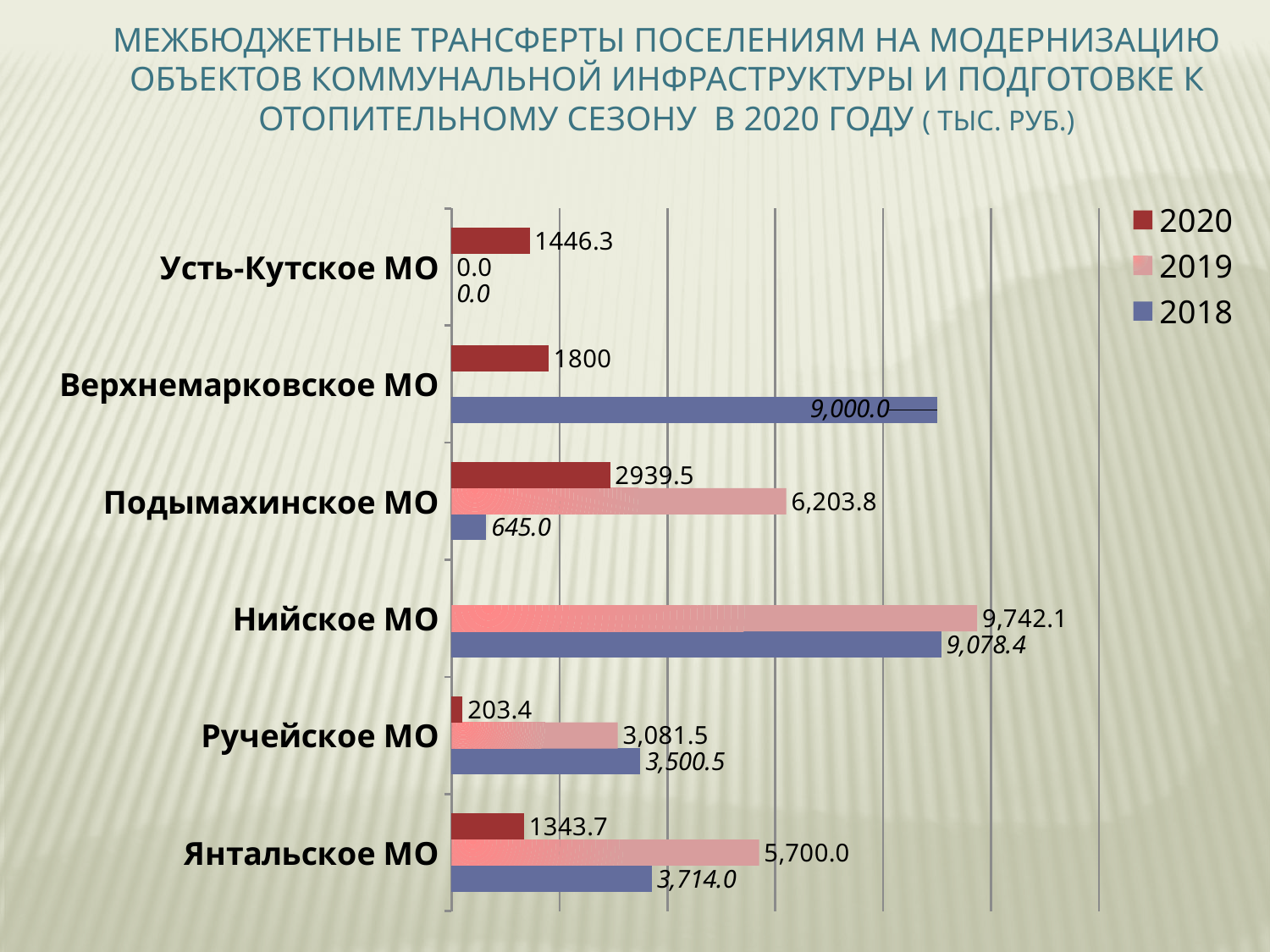
What is the difference between the 2019 and 2018 values for Янтальское МО? 1,986.0 Which municipality has the highest 2020 value? Подымахинское МО What is the 2018 value for Верхнемарковское МО? 9,000.0 What is the 2019 value for Янтальское МО? 5,700.0 What is the 2020 value for Подымахинское МО? 2939.5 What kind of chart is shown on the slide? Bar chart What is the 2019 value for Нийское МО? 9,742.1 How many municipalities are shown on the chart? 6 Which municipality has the lowest non-zero 2020 value? Ручейское МО Which colour represents the 2018 series in the legend? Blue How many series does the legend list? 3 For Ручейское МО, which is larger: the 2019 value or the 2018 value? 2018